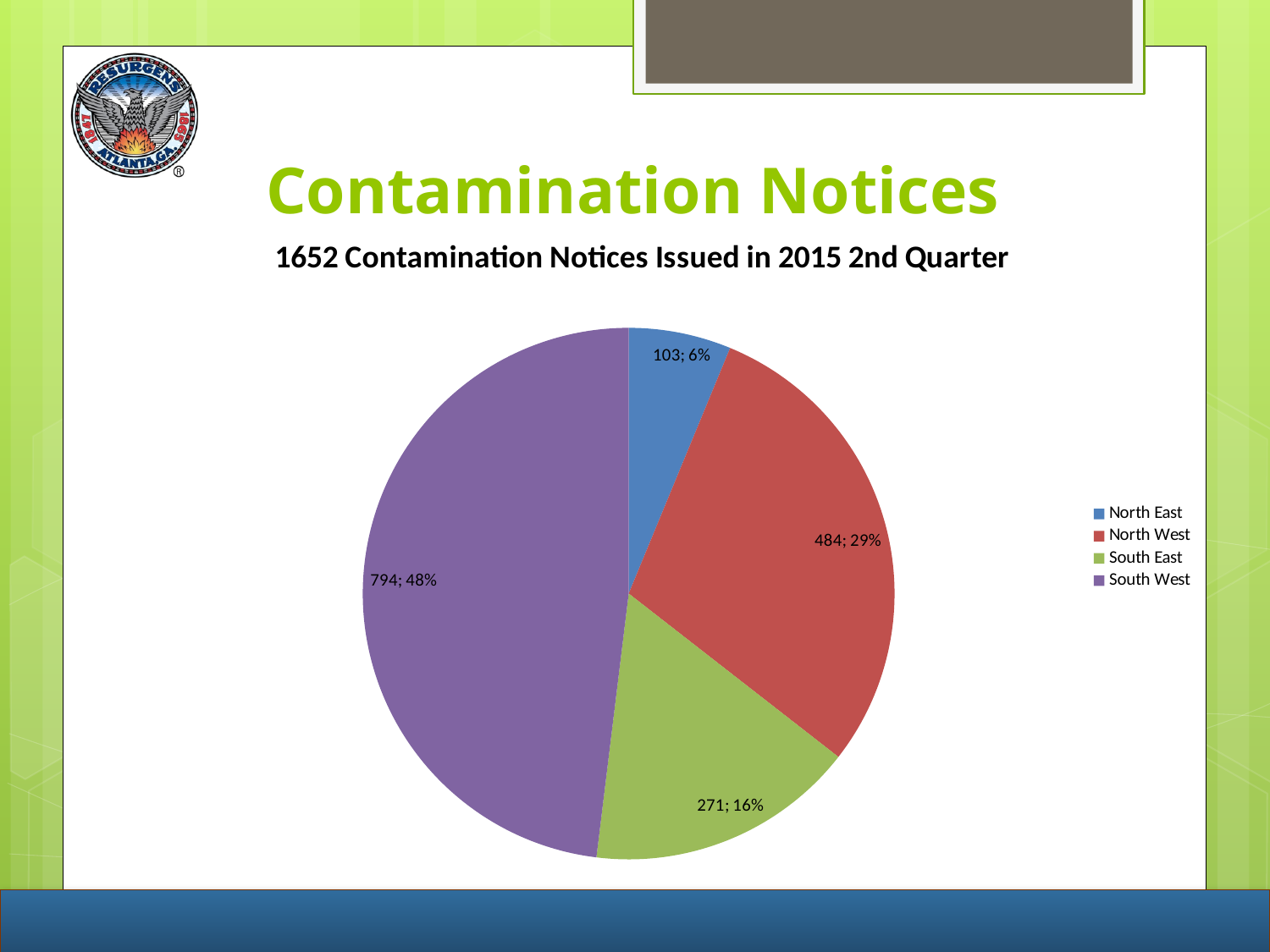
Which region had more contamination notices, South East or North West? North West What is the difference between the number of notices in South West and North West? 310 Which region has the smallest slice of the pie? North East How many regions are shown in the pie chart? 4 How many contamination notices were issued in the North West? 484 Which region has the largest slice of the pie? South West What percentage share of the pie does South West have? 48% Which colour represents South East in the legend? green How many contamination notices were issued in the North East? 103 What percentage share of the pie does South East have? 16% What is the chart's title? 1652 Contamination Notices Issued in 2015 2nd Quarter What kind of chart is shown on the slide? pie chart